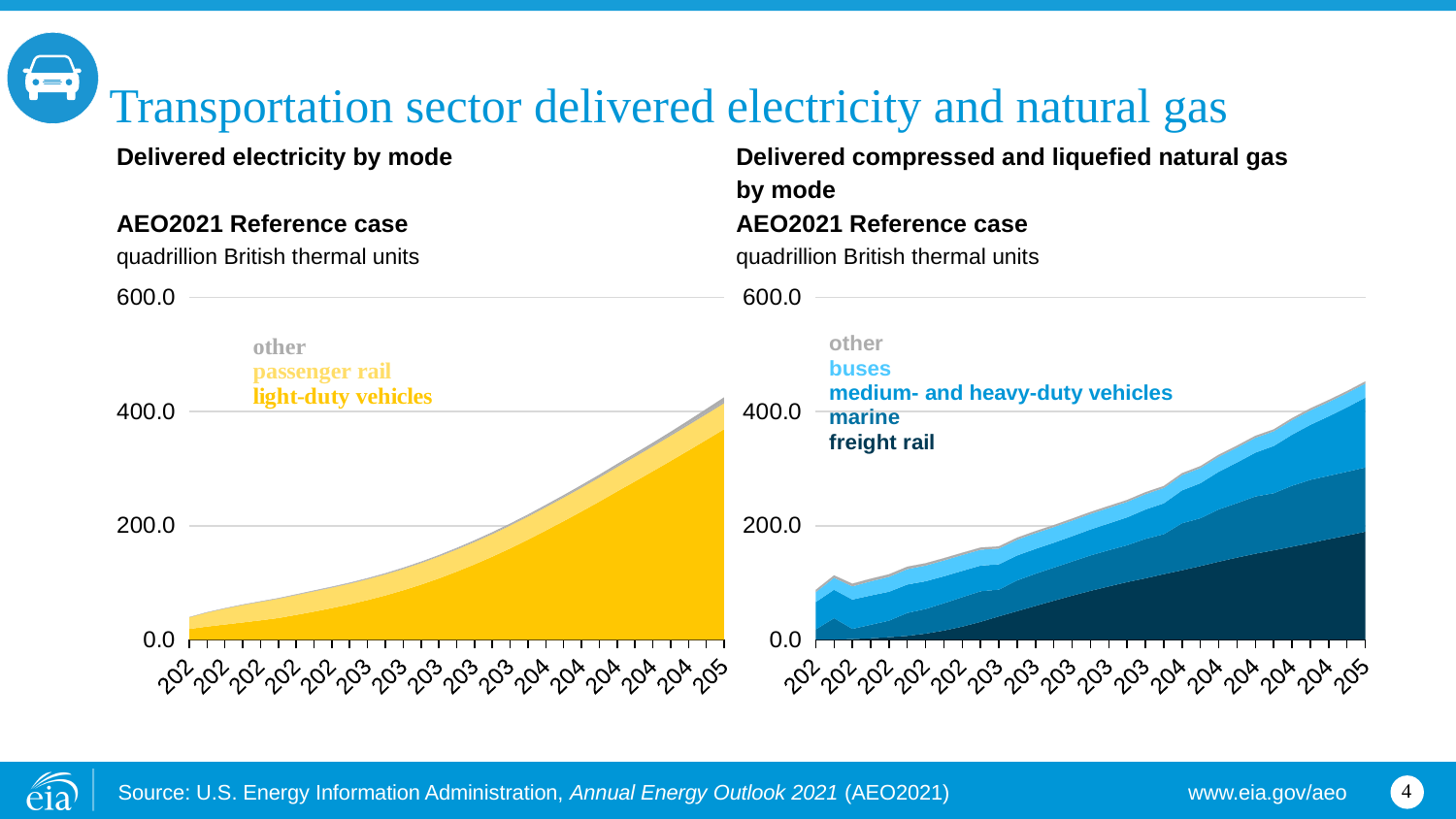
In the 'Delivered electricity by mode' chart, is the total value at the final year greater or less than 400.0? greater In the 'Delivered electricity by mode' chart, do the total values rise or fall over time along the x axis? rise In the 'Delivered electricity by mode' chart, is the total value at the first year greater or less than 200.0? less What kind of chart is the 'Delivered electricity by mode' chart on the left? stacked area chart In the 'Delivered electricity by mode' chart, which series accounts for the largest share of the total? light-duty vehicles How many series does the legend of the 'Delivered compressed and liquefied natural gas by mode' chart list? 5 How many series does the legend of the 'Delivered electricity by mode' chart list? 3 In the 'Delivered compressed and liquefied natural gas by mode' chart, do the total values rise or fall over time along the x axis? rise What kind of chart is the 'Delivered compressed and liquefied natural gas by mode' chart on the right? stacked area chart What unit is used on the y axis of both charts? quadrillion British thermal units In the 'Delivered compressed and liquefied natural gas by mode' chart, is the total value at the final year greater or less than 400.0? greater